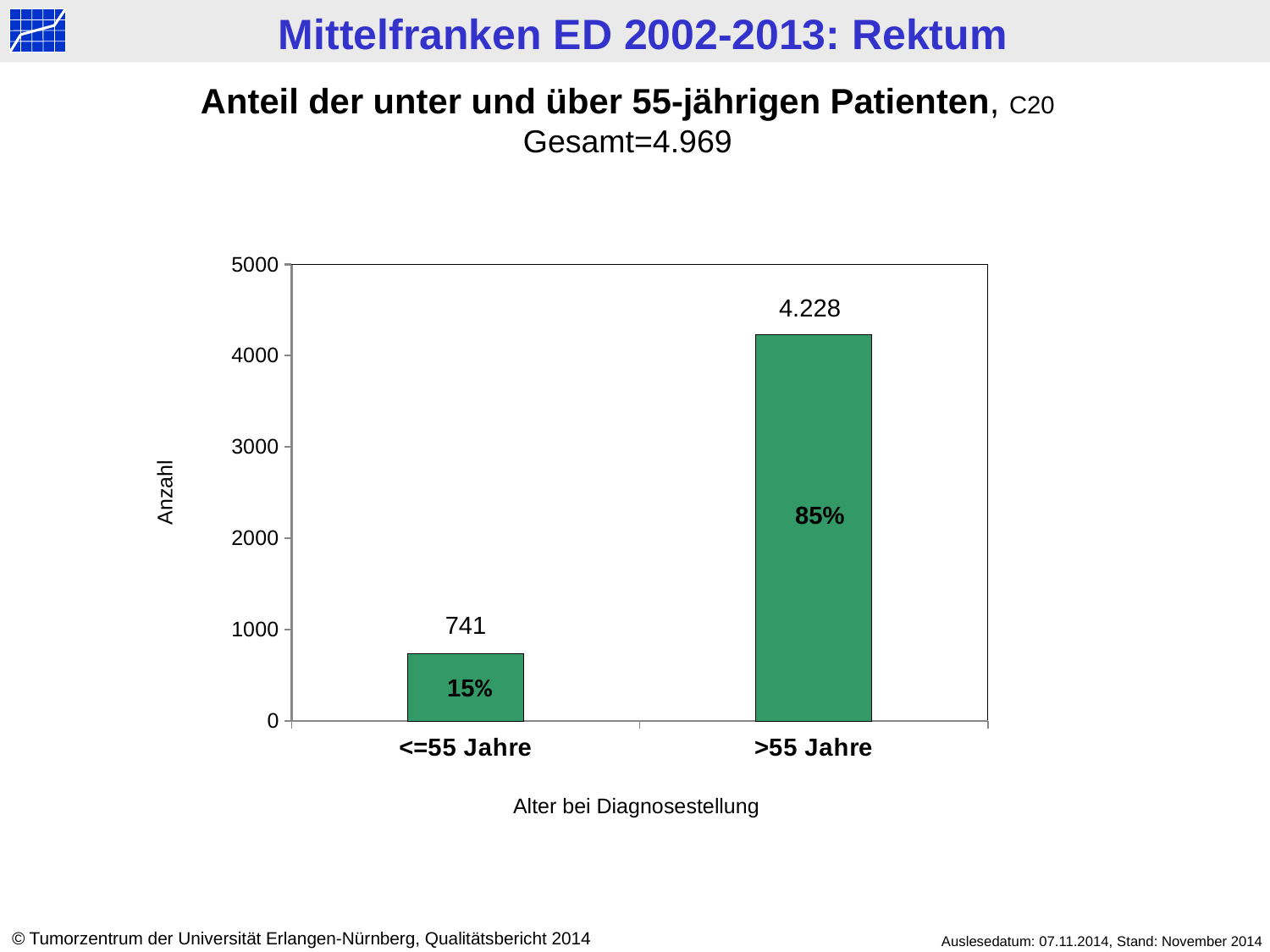
What is the difference between the values for ">55 Jahre" and "<=55 Jahre"? 3.487 Which category has the lowest value? <=55 Jahre Is the value for ">55 Jahre" greater or less than 4000? greater Which category has the highest value? >55 Jahre What is the value for the "<=55 Jahre" category? 741 What percentage is shown on the ">55 Jahre" bar? 85% What percentage is shown on the "<=55 Jahre" bar? 15% How many categories are shown on the x axis? 2 What kind of chart is shown on the slide? bar chart What is the label of the x axis? Alter bei Diagnosestellung What is the value for the ">55 Jahre" category? 4.228 Is the value for "<=55 Jahre" greater or less than 1000? less